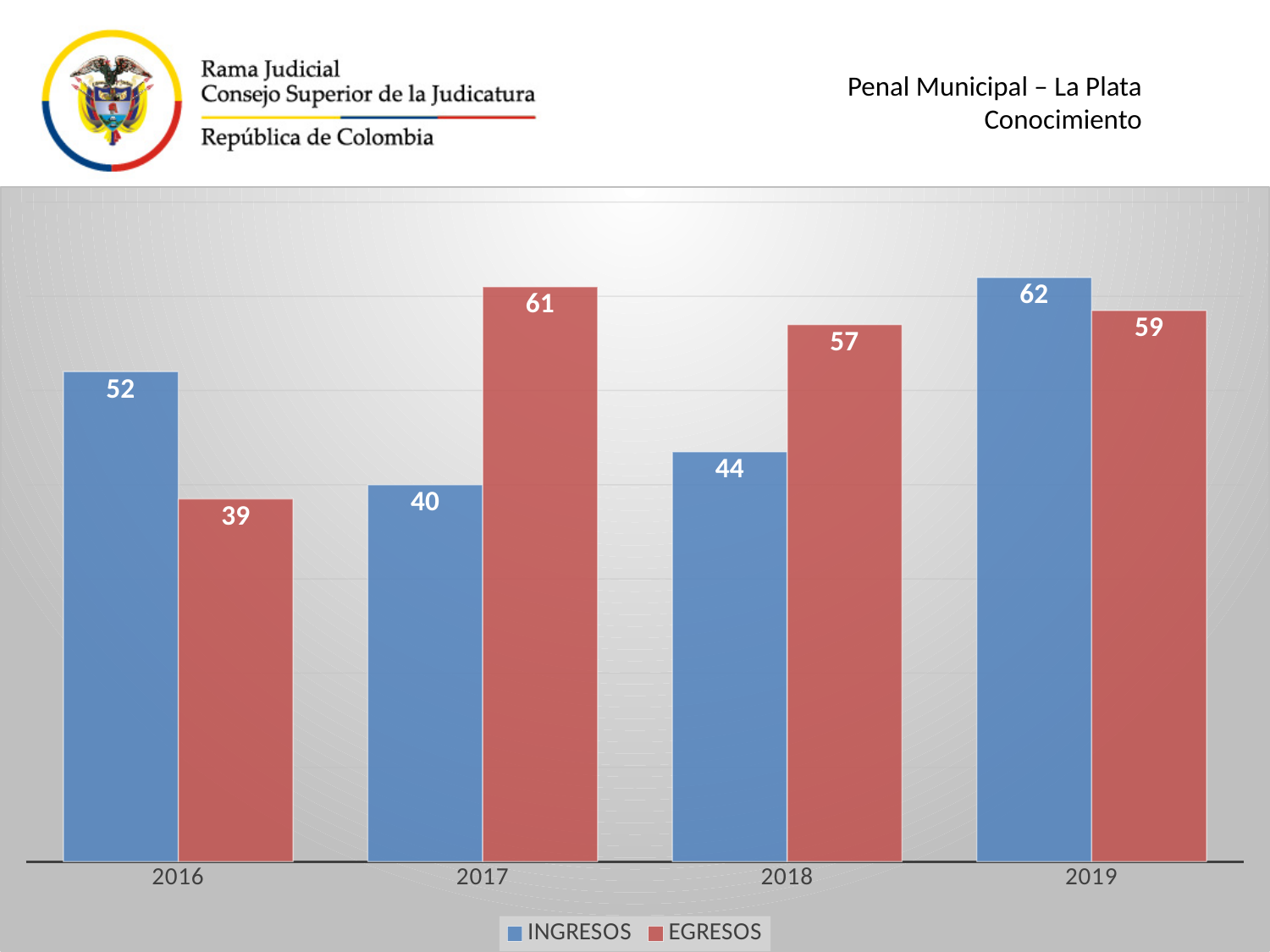
What kind of chart is shown on the slide? bar chart Which colour represents EGRESOS in the legend? red What is the EGRESOS value for 2019? 59 Which year has the lowest EGRESOS value? 2016 In 2018, which is larger, INGRESOS or EGRESOS? EGRESOS What is the EGRESOS value for 2017? 61 Which year has the highest INGRESOS value? 2019 How many series does the legend list? 2 What is the INGRESOS value for 2016? 52 How many years are shown on the x axis? 4 What is the INGRESOS value for 2018? 44 What is the difference between EGRESOS and INGRESOS in 2017? 21